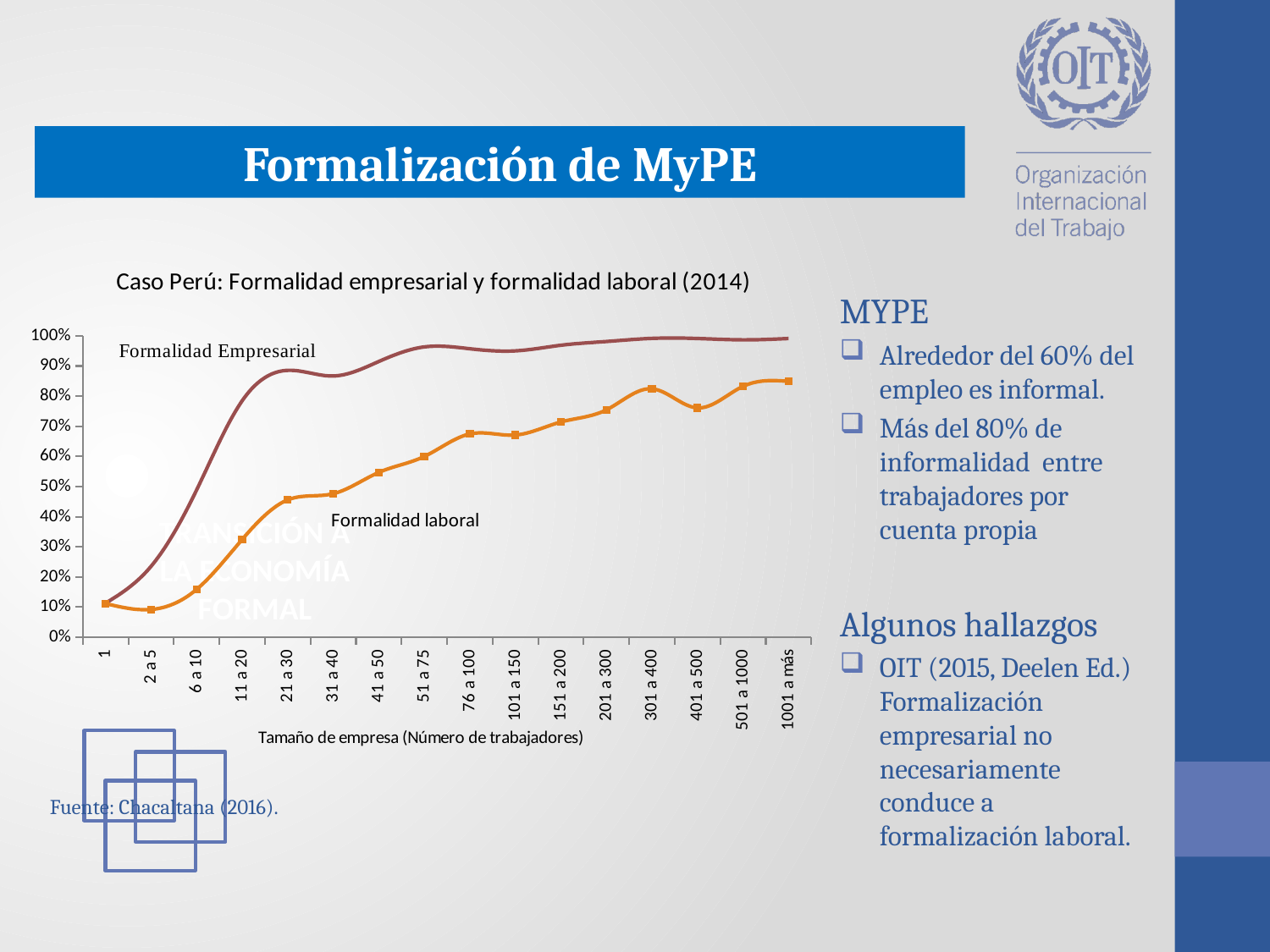
Is the value of Formalidad Empresarial for the category '21 a 30' greater or less than 80%? greater How many series are plotted in the chart? 2 What kind of chart is shown on the slide? Line chart Is the value of Formalidad laboral for the category '76 a 100' greater or less than 60%? greater How many company-size categories are shown on the x axis? 16 For the category '11 a 20', which series has the higher value, Formalidad Empresarial or Formalidad laboral? Formalidad Empresarial Do the values of Formalidad laboral generally rise or fall as company size increases along the x axis? Rise What is the label of the x axis? Tamaño de empresa (Número de trabajadores) Is the value of Formalidad laboral for the category '21 a 30' greater or less than 50%? less What is the title of the chart? Caso Perú: Formalidad empresarial y formalidad laboral (2014)